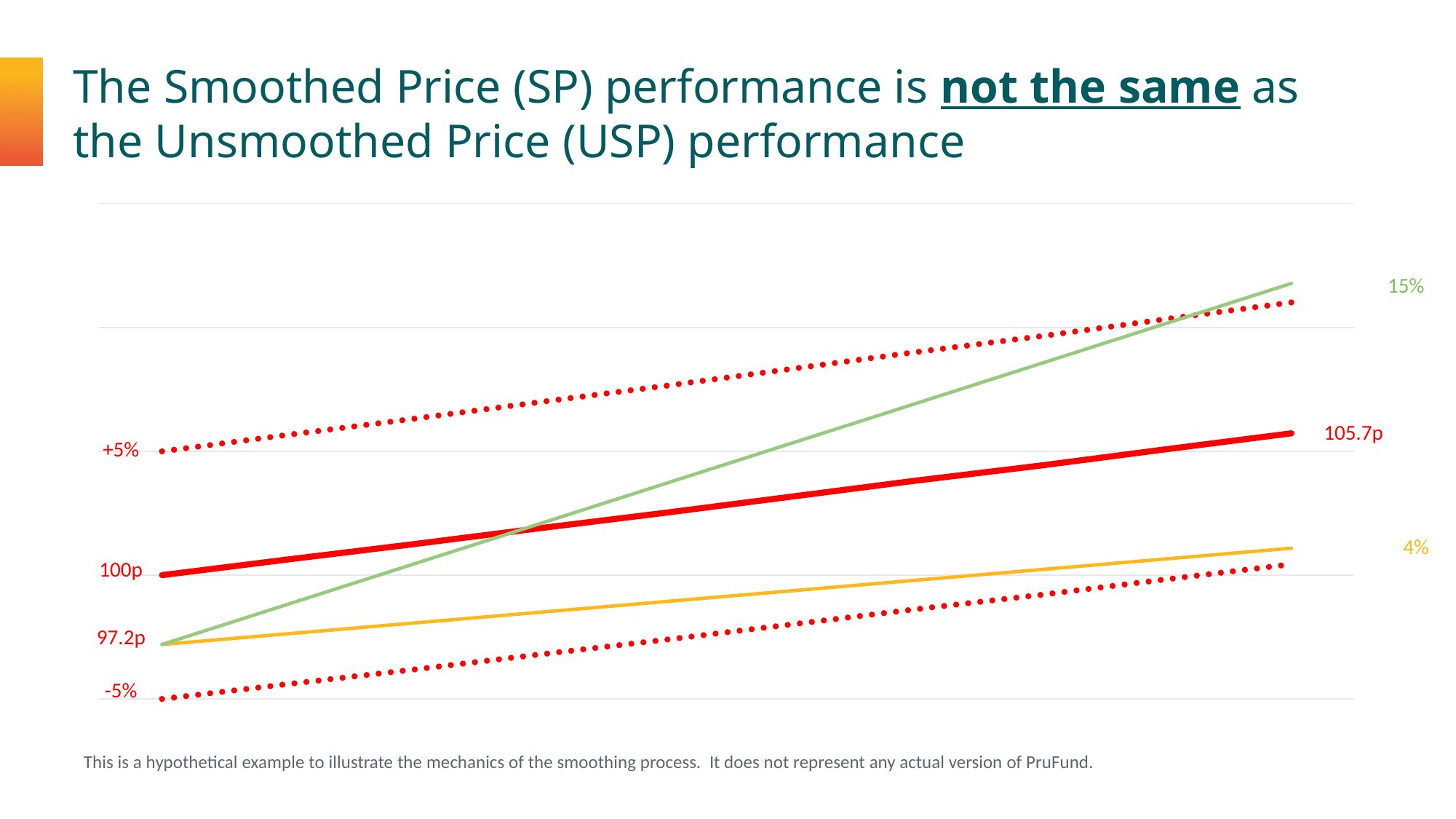
What kind of chart is shown on the slide? line chart What labels are shown at the left end of the upper and lower dotted red lines? +5% and -5% What is the ending value labelled on the thick solid red line? 105.7p Does the thick solid red line rise or fall from left to right? rise What value is labelled at the start of the green and orange lines? 97.2p What is the starting value labelled on the thick solid red line? 100p What percentage is labelled at the end of the green line? 15% What percentage is labelled at the end of the orange line? 4% Which line ends highest on the chart? green line Which line ends higher, the green line or the orange line? green line How many lines are plotted on the chart? 5 By how much does the thick solid red line rise from its labelled start to its labelled end? 5.7p